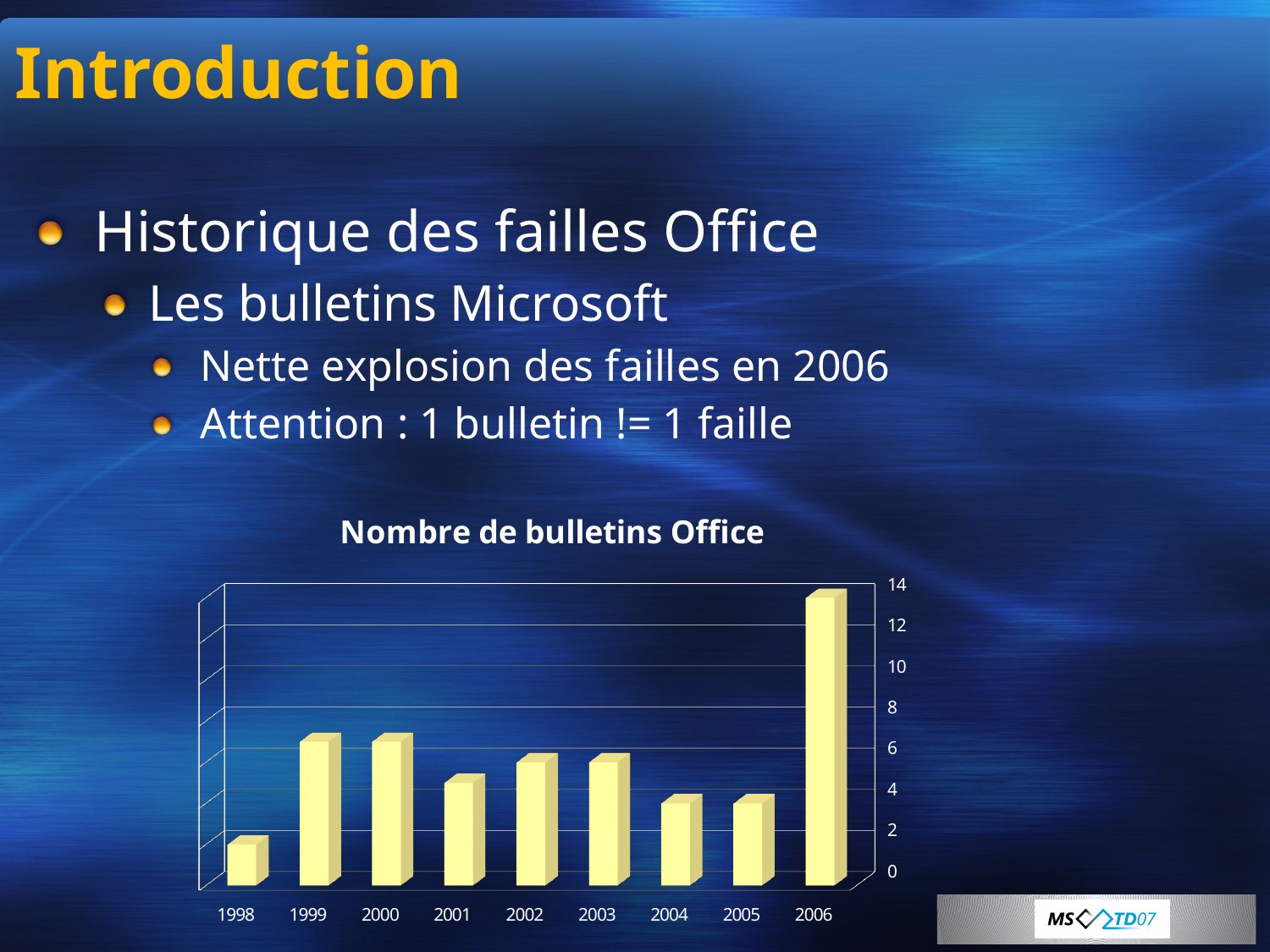
Which year has the larger value, 2001 or 1999? 1999 Which year has the larger value, 1998 or 2004? 2004 Which year has the lowest number of bulletins? 1998 What is the title of the chart? Nombre de bulletins Office Is the value for 1999 greater or less than 4? greater Which year has the highest number of bulletins? 2006 Which year has the larger value, 2006 or 1999? 2006 How many years are shown on the x axis of the chart? 9 Is the value for 2006 greater or less than 12? greater What type of chart is shown on the slide? bar chart